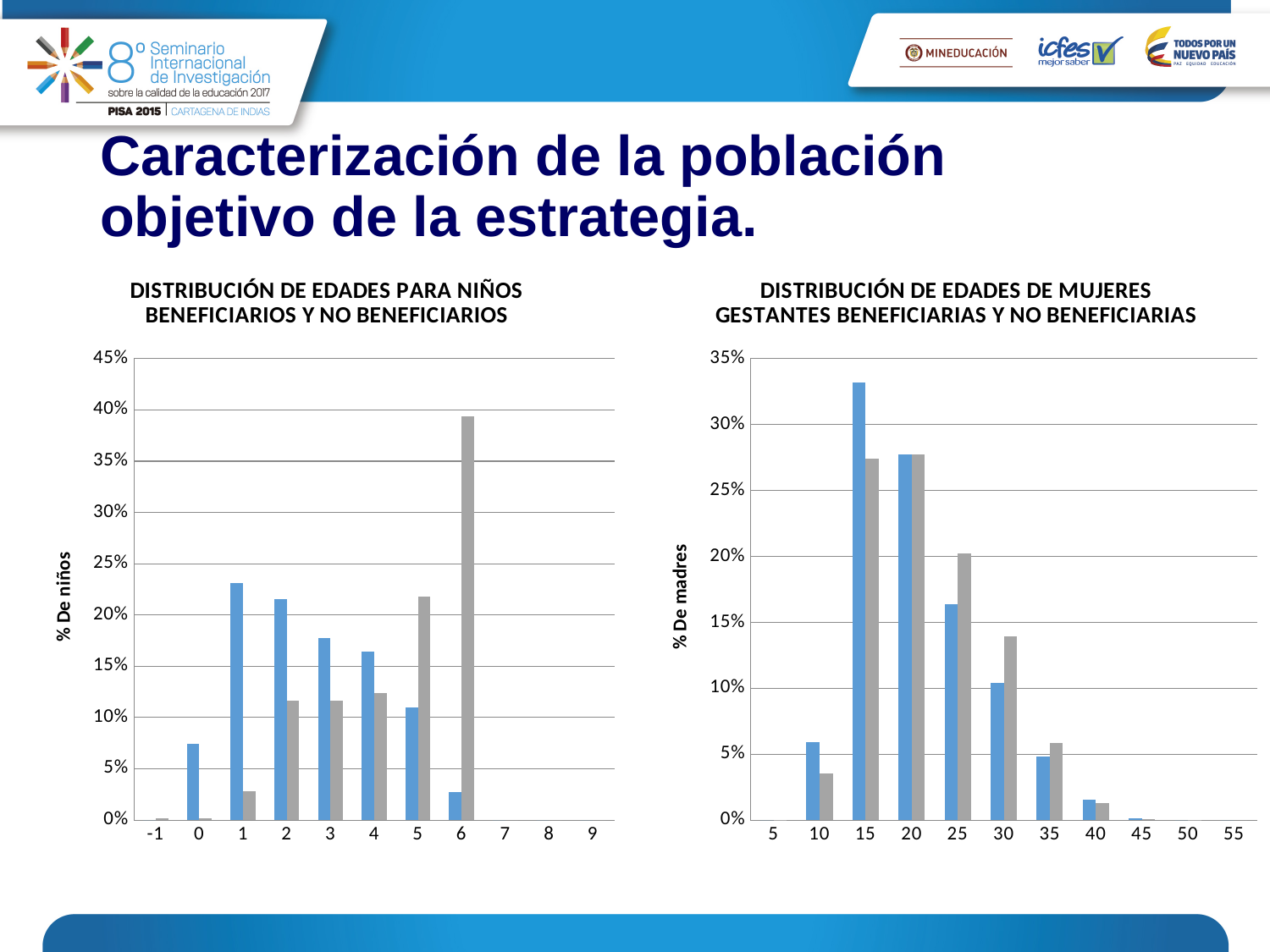
In the left chart (niños), at which age is the tallest blue bar? 1 What kind of chart is the left chart, 'Distribución de edades para niños beneficiarios y no beneficiarios'? Bar chart In the left chart (niños), at age 5, which bar is taller, the blue one or the gray one? The gray one In the right chart (mujeres gestantes), is the blue bar at age 15 greater or less than 30%? greater What is the y-axis label of the right chart (mujeres gestantes)? % De madres In the right chart (mujeres gestantes), do the bars rise or fall along the x axis from age 20 to age 45? Fall In the right chart (mujeres gestantes), at which age is the tallest blue bar? 15 How many age values are labelled on the x axis of the left chart (niños)? 11 In the left chart (niños), is the blue bar at age 0 greater or less than 10%? less In the left chart (niños), at which age is the tallest gray bar? 6 In the left chart (niños), is the gray bar at age 6 greater or less than 35%? greater In the right chart (mujeres gestantes), at age 25, which bar is taller, the blue one or the gray one? The gray one